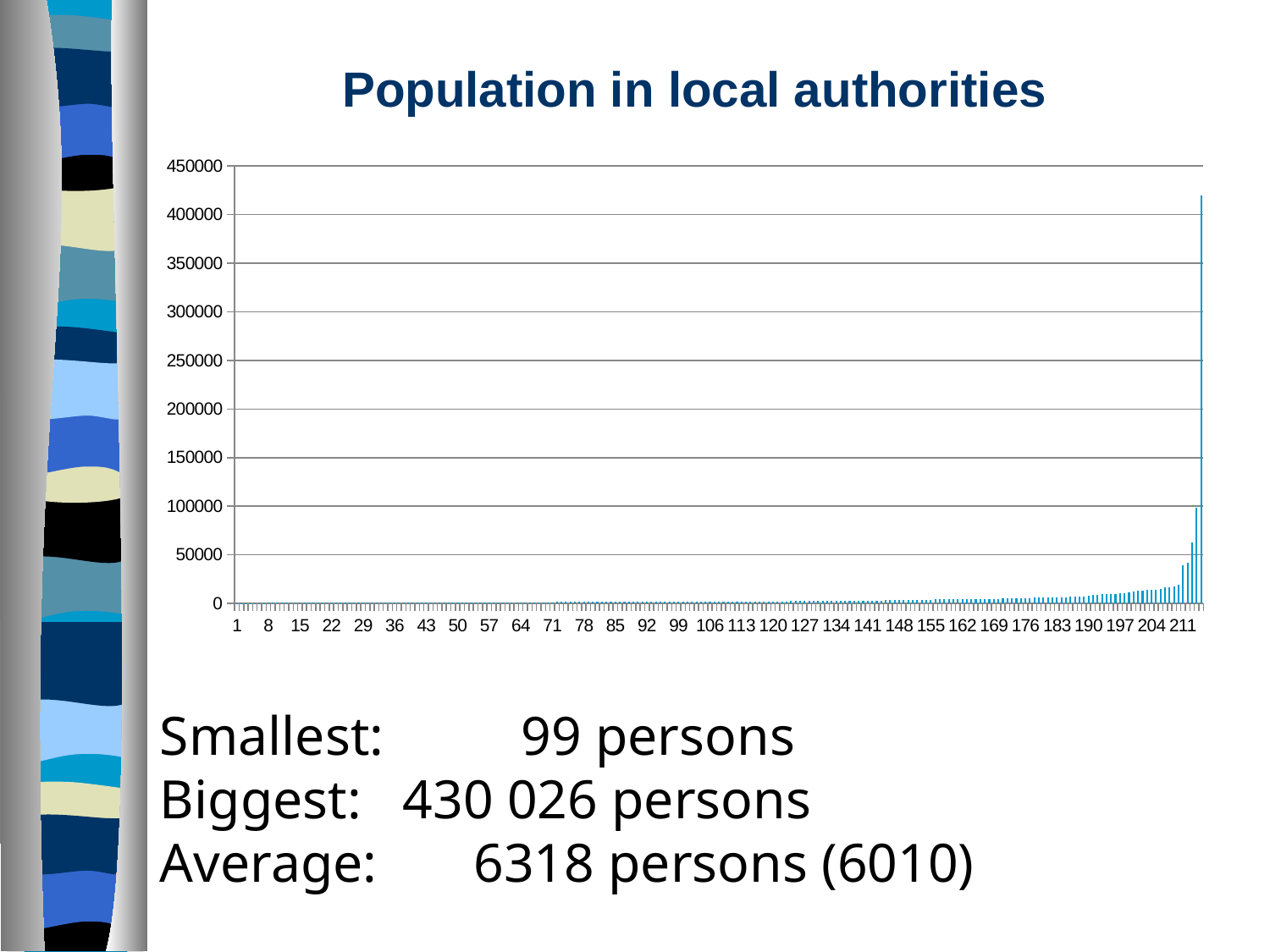
What type of chart is shown on the slide? Bar chart What is the title of the chart? Population in local authorities Which is larger: the biggest local authority population or the average population stated on the slide? Biggest (430 026 persons) Is the value of the tallest bar at the right end of the chart greater or less than 400000? greater According to the slide, what is the average population of a local authority? 6318 persons According to the slide, what is the population of the biggest local authority? 430 026 persons What is the highest value shown on the y axis? 450000 What is the difference between the biggest and smallest local authority populations stated on the slide? 429 927 persons Is the value of the bar at position 1 greater or less than 50000? less Do the bar values rise or fall moving from left to right along the x axis? Rise Is the value of the bar at position 106 greater or less than 50000? less According to the slide, what is the population of the smallest local authority? 99 persons